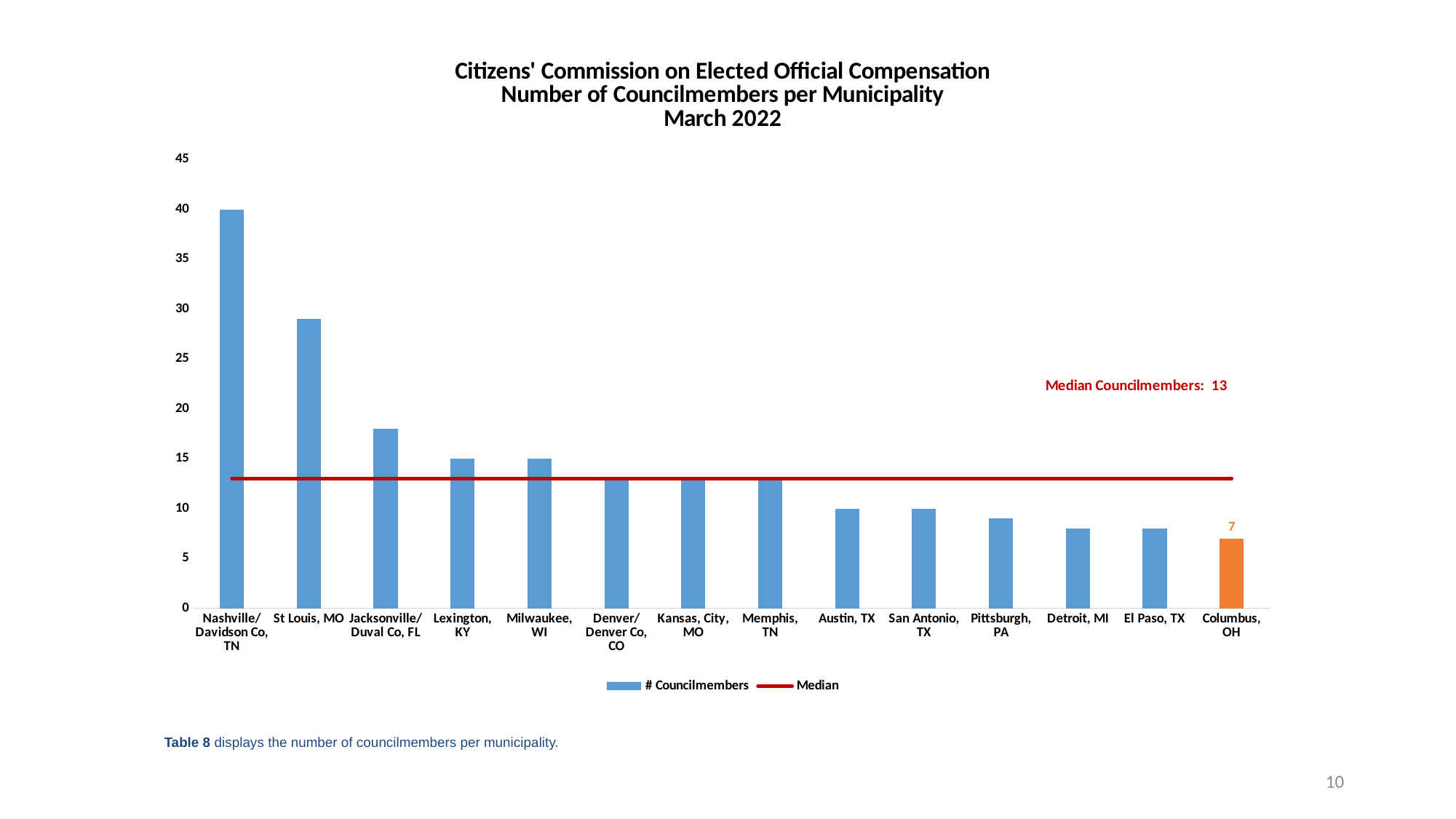
What colour is the bar for Columbus, OH? Orange How many series does the legend list? 2 Is the value for St Louis, MO greater or less than 25? greater What is the median number of councilmembers shown on the chart? 13 What kind of chart is shown on the slide? Bar chart Is the value for Jacksonville/Duval Co, FL greater or less than 20? less Which municipality has the highest number of councilmembers? Nashville/Davidson Co, TN What is the number of councilmembers shown for Columbus, OH? 7 Which has more councilmembers, St Louis, MO or Jacksonville/Duval Co, FL? St Louis, MO Which municipality has the lowest number of councilmembers? Columbus, OH Do the bar values rise or fall from left to right along the x axis? fall How many municipalities are shown on the x axis? 14